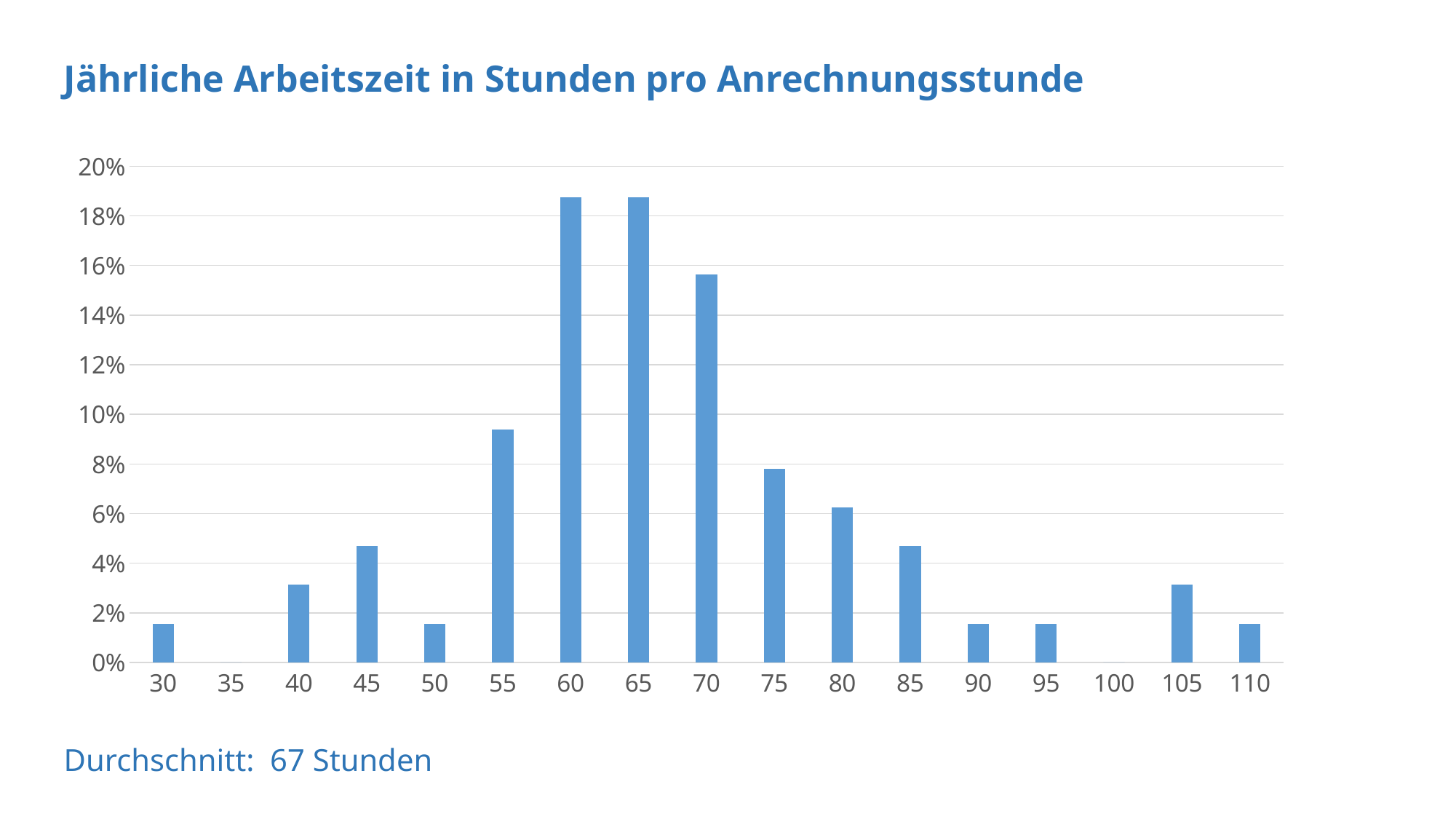
Is the value for 70 greater or less than 14%? greater What average (Durchschnitt) is stated below the chart? 67 Stunden Is the value for 105 greater or less than 2%? greater What is the title of the chart? Jährliche Arbeitszeit in Stunden pro Anrechnungsstunde What kind of chart is shown on the slide? bar chart Is the value for 85 greater or less than 4%? greater Which has the larger value, 55 or 85? 55 How many categories are labelled on the x axis? 17 Which has the larger value, 70 or 75? 70 Which has the larger value, 40 or 45? 45